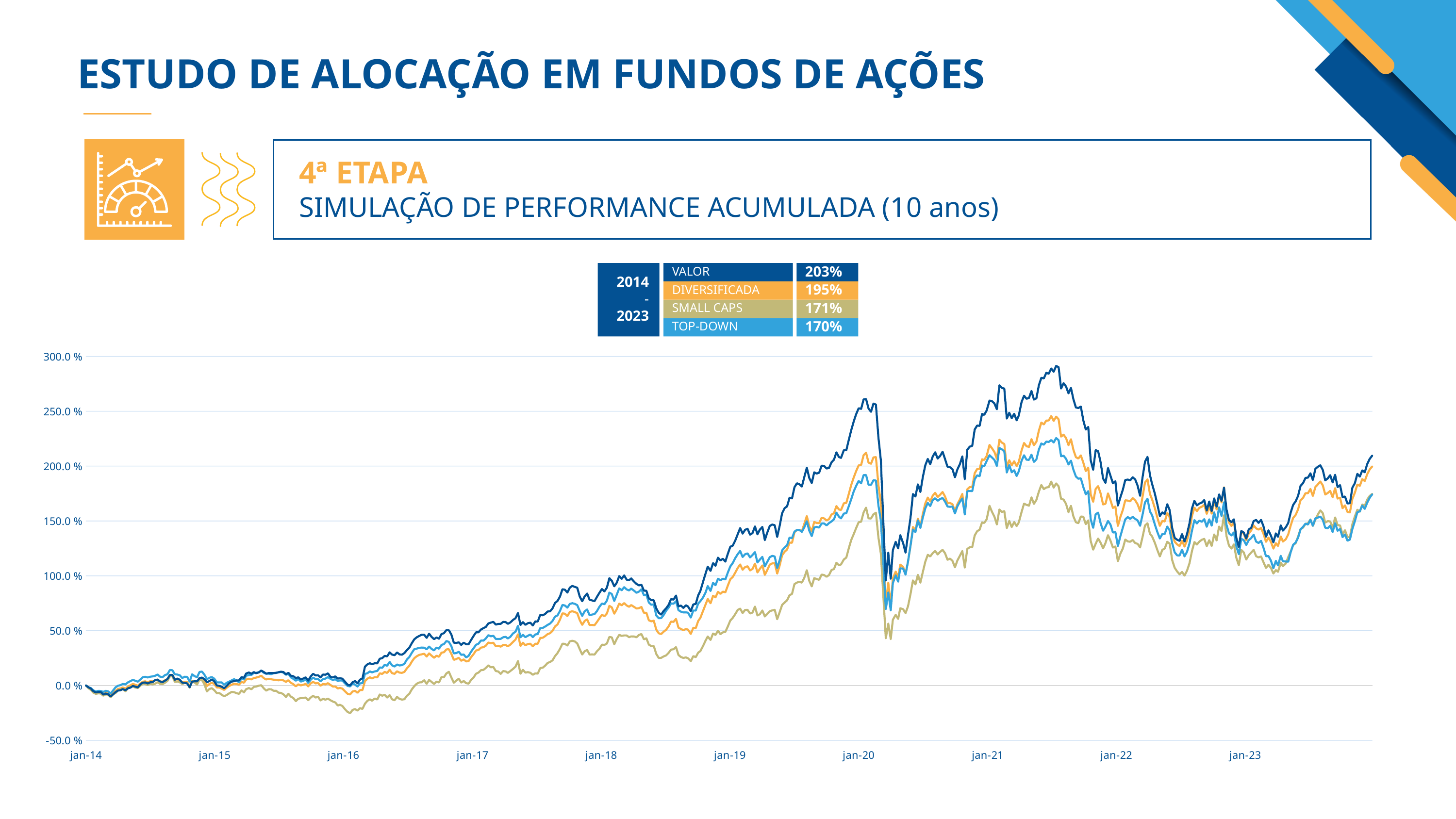
What kind of chart is shown on the slide? Line chart Which strategy has the lowest 2014-2023 cumulative performance? TOP-DOWN What is the 2014-2023 cumulative performance shown for TOP-DOWN? 170% What is the difference between the 2014-2023 cumulative performance of VALOR and DIVERSIFICADA? 8 percentage points What is the 2014-2023 cumulative performance shown for DIVERSIFICADA? 195% Is the peak value of the VALOR line around 2021 greater or less than 250.0 %? greater What is the 2014-2023 cumulative performance shown for VALOR? 203% Which has a higher 2014-2023 cumulative performance, DIVERSIFICADA or SMALL CAPS? DIVERSIFICADA Overall, do the lines rise or fall from jan-14 to jan-23? Rise Which strategy has the highest 2014-2023 cumulative performance? VALOR What is the 2014-2023 cumulative performance shown for SMALL CAPS? 171% How many series are plotted in the chart? 4